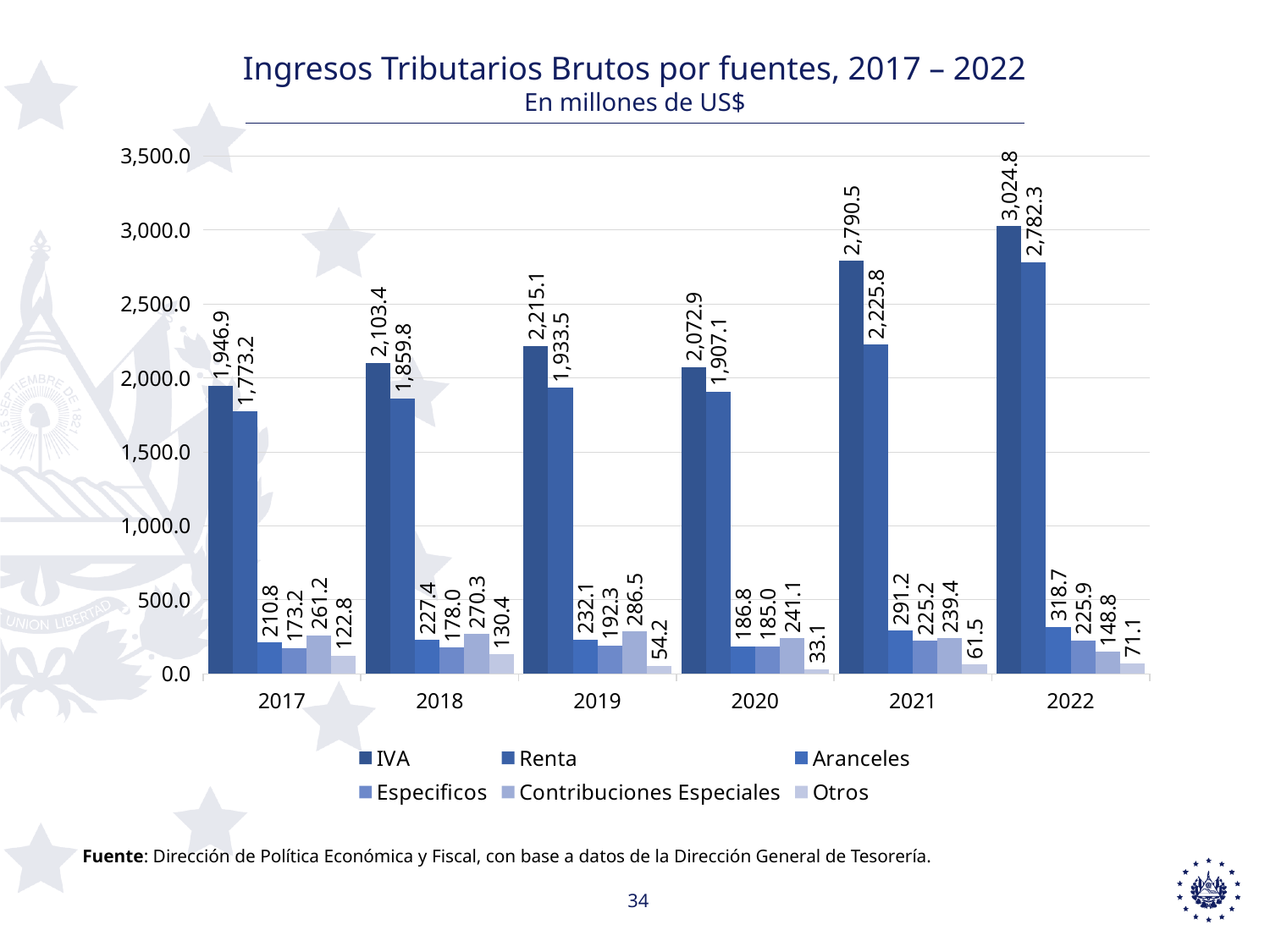
What is the value of Otros in 2020? 33.1 How many years are shown on the x axis? 6 Which is larger in 2017, Aranceles or Contribuciones Especiales? Contribuciones Especiales What is the difference between the IVA values for 2022 and 2021? 234.3 In which year is the IVA value highest? 2022 In which year is the Otros value lowest? 2020 What is the value of Contribuciones Especiales in 2018? 270.3 How many series does the legend list? 6 What kind of chart is shown on the slide? Bar chart What unit is stated in the chart subtitle? En millones de US$ What is the value of IVA in 2022? 3,024.8 What is the value of Renta in 2019? 1,933.5